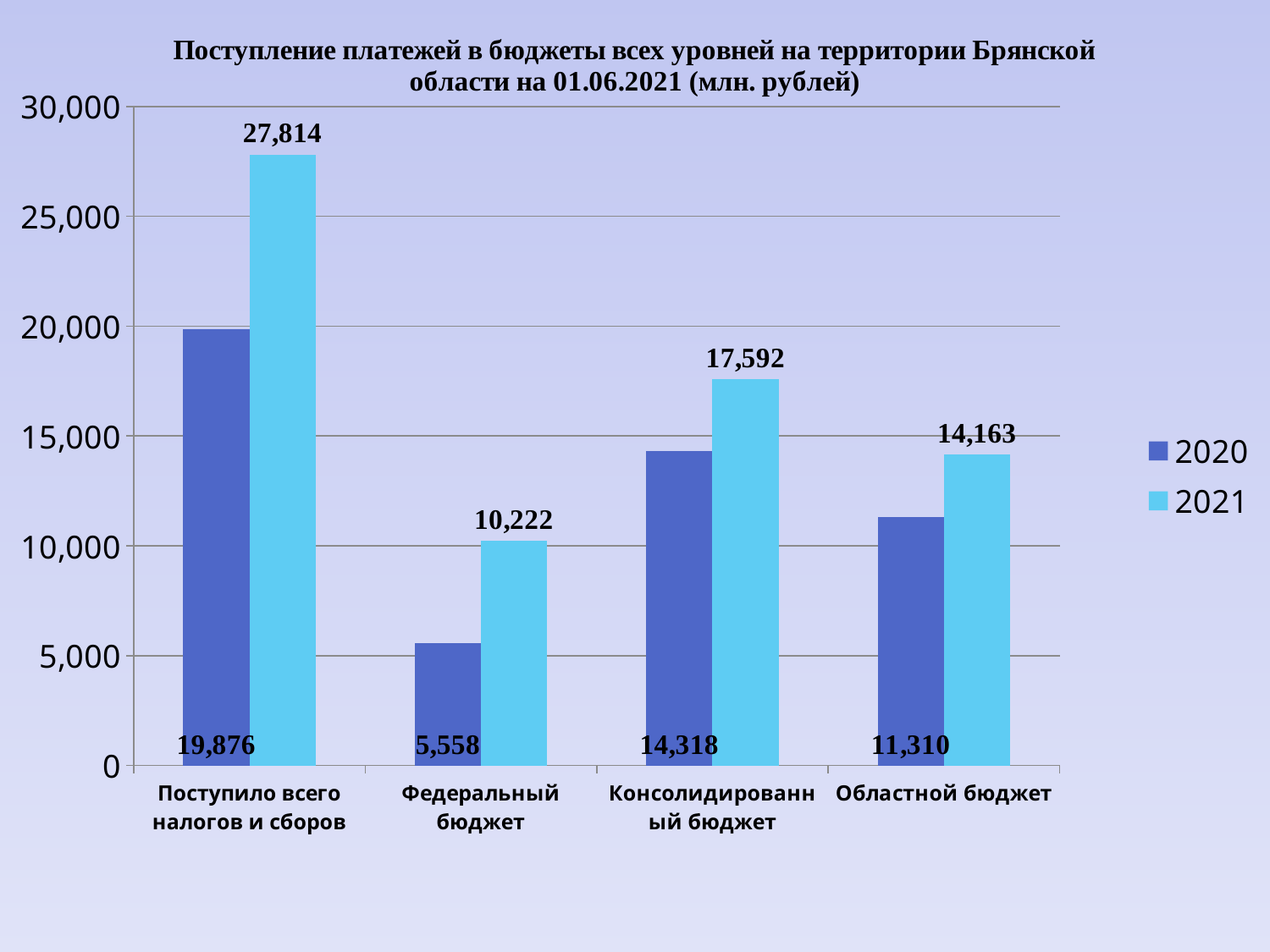
Which category has the highest 2020 value? Поступило всего налогов и сборов How many series does the legend list? 2 What is the 2021 value for Консолидированный бюджет? 17,592 How many categories are shown on the x axis? 4 What is the difference between the 2021 and 2020 values for Федеральный бюджет? 4,664 What is the 2020 value for Областной бюджет? 11,310 Which category has the lowest 2021 value? Федеральный бюджет What kind of chart is shown on the slide? Bar chart What is the 2020 value for Федеральный бюджет? 5,558 What is the difference between the 2021 and 2020 values for Поступило всего налогов и сборов? 7,938 What is the 2021 value for Поступило всего налогов и сборов? 27,814 Which is larger: the 2020 value for Консолидированный бюджет or the 2021 value for Областной бюджет? 2020 value for Консолидированный бюджет